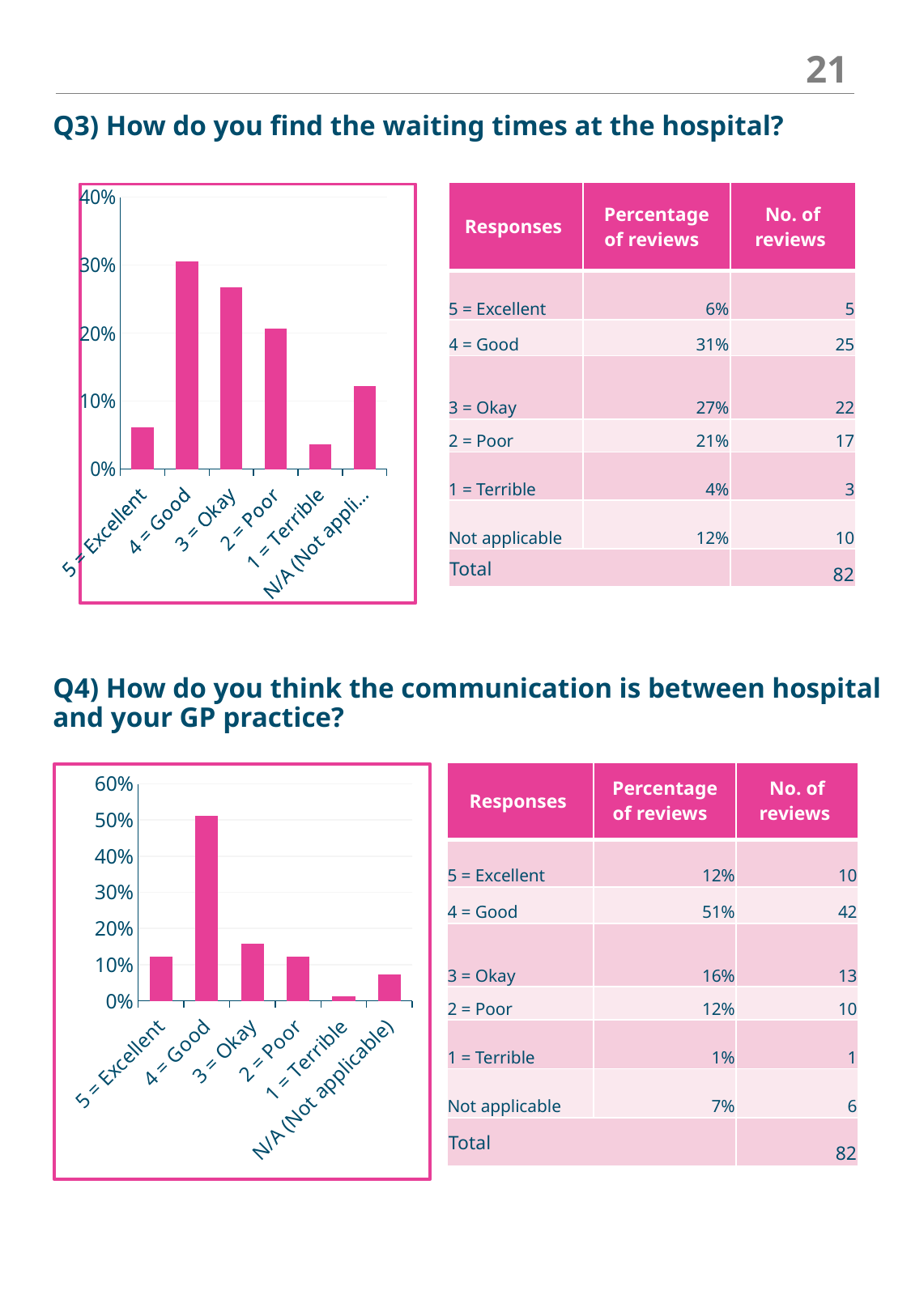
In the Q3 waiting times chart, which category has the lowest bar? 1 = Terrible In the Q4 communication chart, which is larger, the bar for 3 = Okay or the bar for N/A (Not applicable)? 3 = Okay In the Q4 communication chart, which category has the lowest bar? 1 = Terrible In the Q3 waiting times chart, what is the difference in percentage between 4 = Good and 3 = Okay? 4% In the Q3 waiting times chart, is the value for 2 = Poor greater or less than 20%? greater In the Q4 communication chart, is the value for 4 = Good greater or less than 50%? greater In the Q3 waiting times chart, which category has the highest bar? 4 = Good In the Q4 communication chart, which category has the highest bar? 4 = Good In the Q3 waiting times chart, how many categories are shown on the x axis? 6 In the Q3 waiting times chart, what percentage of reviews is shown for 3 = Okay? 27% In the Q4 communication chart, what percentage of reviews is shown for 5 = Excellent? 12% What type of chart is used for Q4? Bar chart